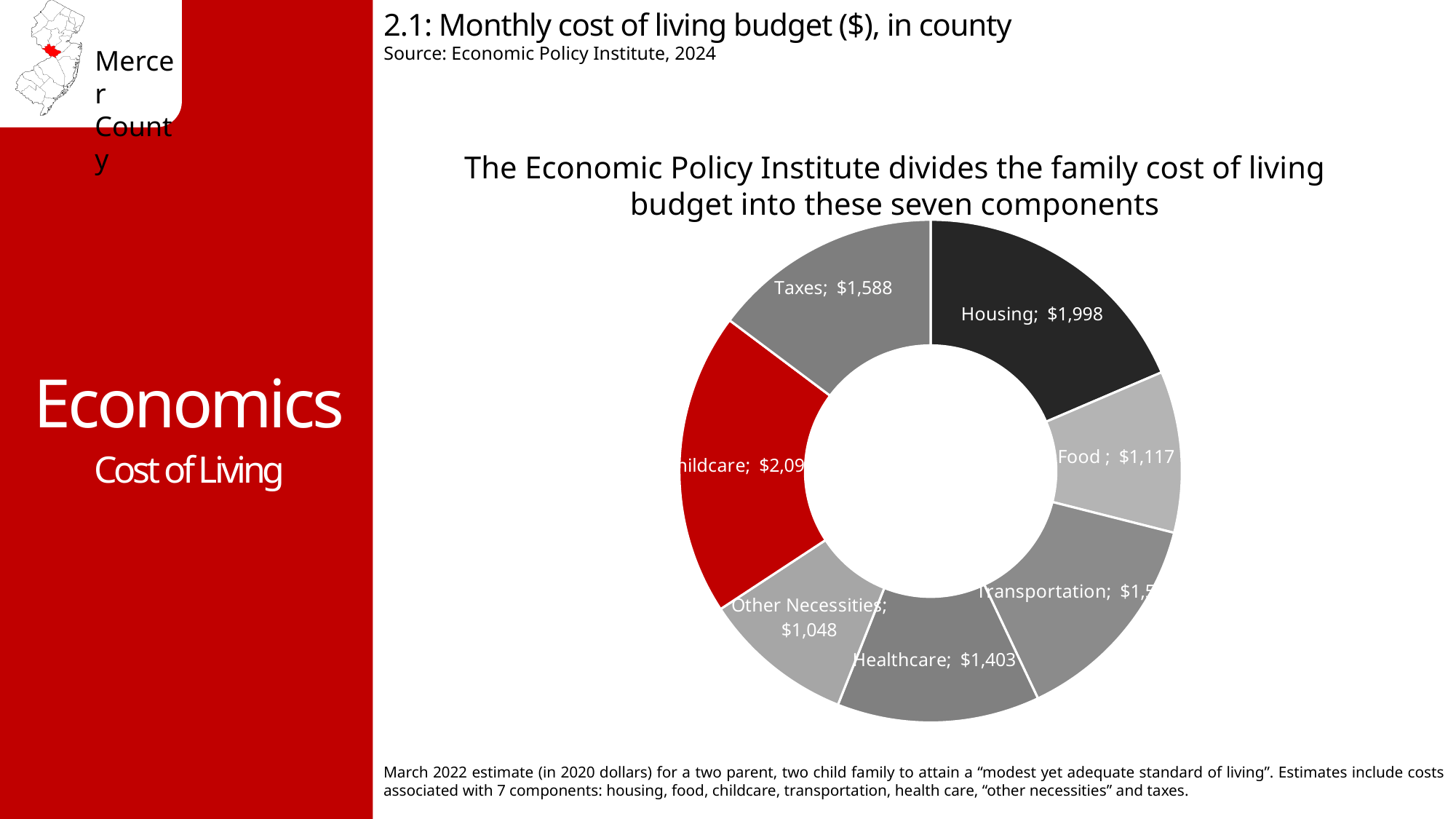
What is the monthly cost for Food? $1,117 Which component has the largest monthly cost? Childcare What is the monthly cost for Other Necessities? $1,048 How many components (slices) does the chart show? 7 What is the monthly cost for Healthcare? $1,403 Which component has the smallest monthly cost? Other Necessities What is the monthly cost for Housing? $1,998 What is the monthly cost for Taxes? $1,588 What type of chart is shown on the slide? Doughnut (pie) chart Which is larger, the Taxes cost or the Healthcare cost? Taxes What is the difference between the Housing cost and the Food cost? $881 What is the source cited for the chart? Economic Policy Institute, 2024